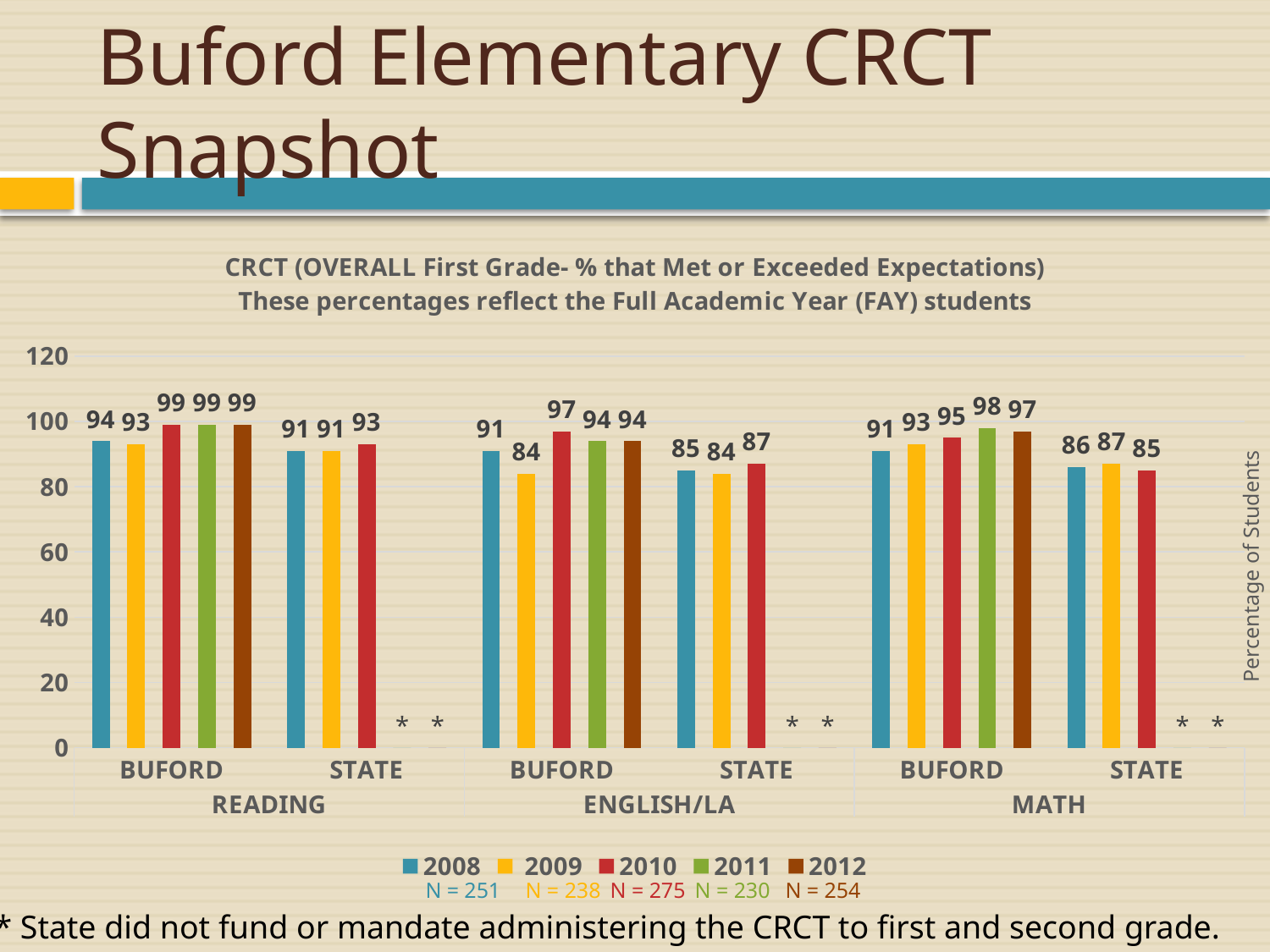
What kind of chart is shown on the slide? bar chart What is the 2009 value for Buford in English/LA? 84 What is the 2010 value for Buford in Reading? 99 What is the 2010 value for State in English/LA? 87 According to the legend, what is the N for 2010? N = 275 How many series does the legend list? 5 Is the 2009 value for State in Math greater or less than 80? greater Which is larger, the 2008 value for Buford in Reading or the 2008 value for State in Reading? Buford in Reading What is the 2011 value for Buford in Math? 98 What is the difference between the 2010 values for Buford and State in English/LA? 10 Which year has the highest value for Buford in Math? 2011 Which year has the lowest value for Buford in English/LA? 2009